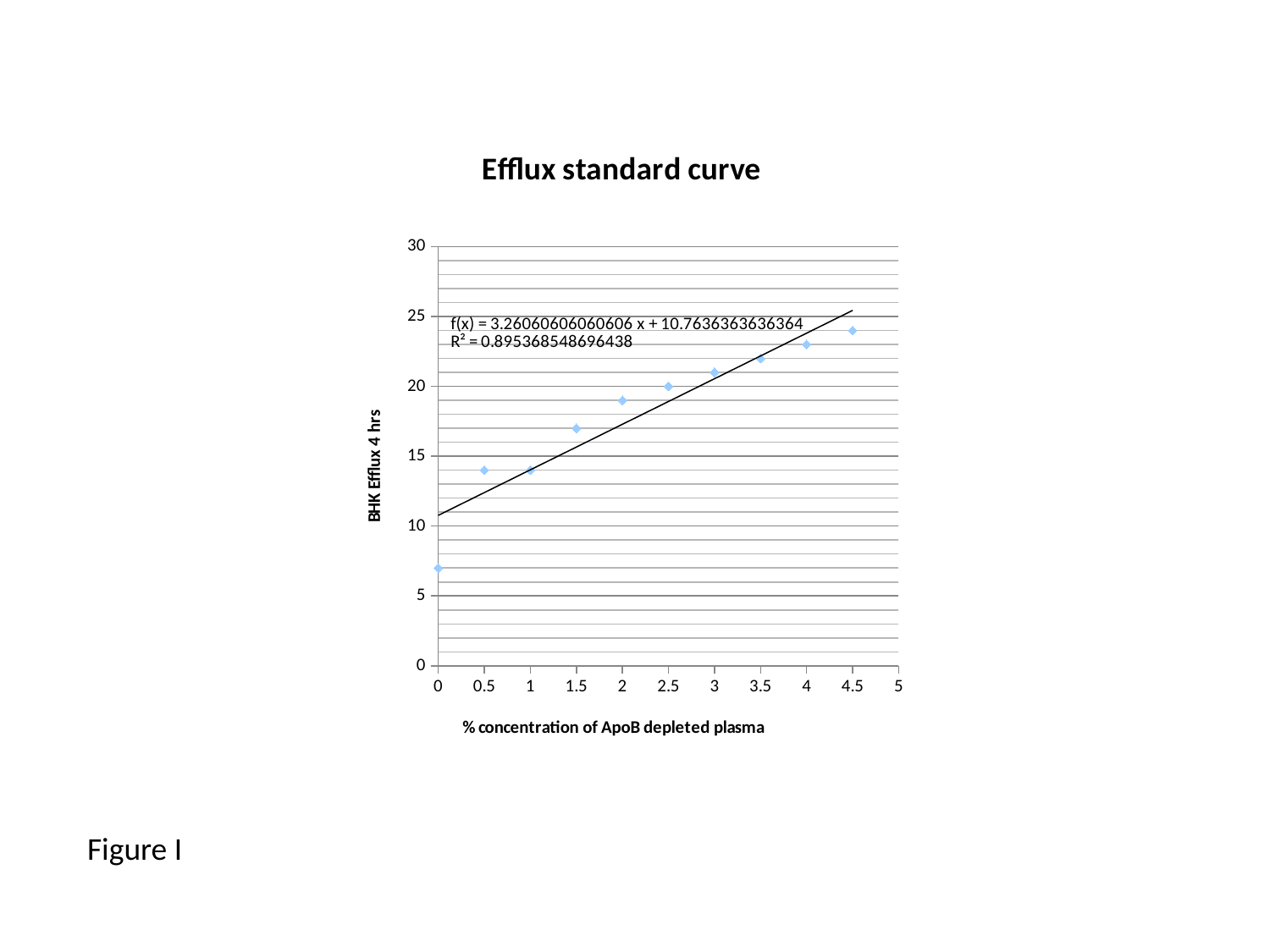
What is the title of the chart? Efflux standard curve Which has the larger BHK Efflux value: 3% concentration or 1.5% concentration? 3% Is the BHK Efflux value at 4.5% concentration greater or less than 20? greater Is the BHK Efflux value at 0% concentration greater or less than 10? less What kind of chart is shown on the slide? scatter chart At which % concentration of ApoB depleted plasma is the BHK Efflux value lowest? 0 Which has the larger BHK Efflux value: 0.5% concentration or 0% concentration? 0.5% What is the R² value printed on the chart? 0.895368548696438 At which % concentration of ApoB depleted plasma is the BHK Efflux value highest? 4.5 How many data points are plotted on the chart? 10 Is the BHK Efflux value at 1.5% concentration greater or less than 15? greater Do the BHK Efflux values generally rise or fall as the % concentration of ApoB depleted plasma increases? rise